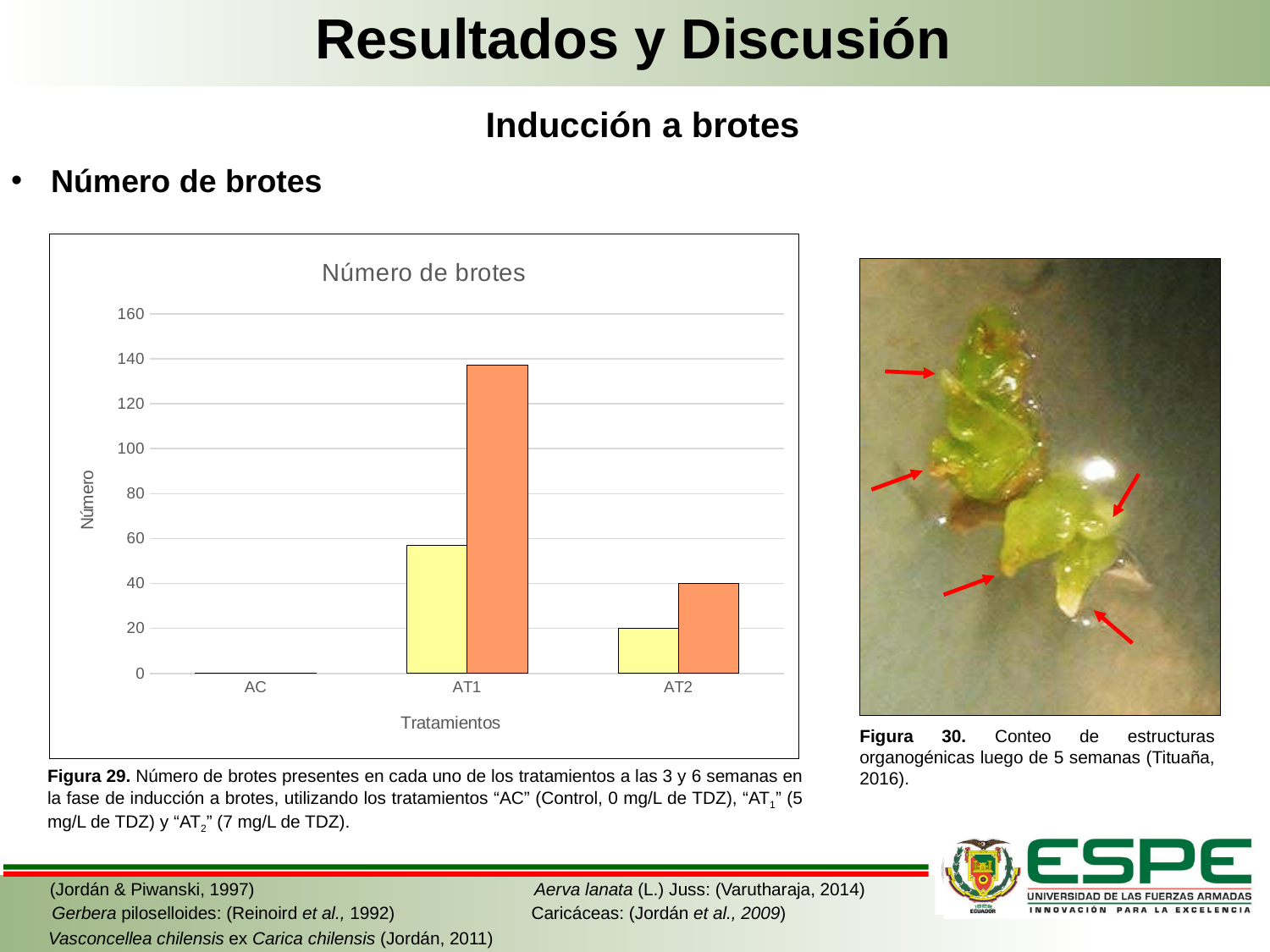
What is the label of the x axis of the chart? Tratamientos Is the value of the orange bar for AT1 greater or less than 120? greater What is the title of the chart? Número de brotes Which is larger, the orange bar for AT1 or the orange bar for AT2? AT1 Which treatment has the tallest bar in the chart? AT1 Is the value of the yellow bar for AT2 greater or less than 40? less Is the value of the yellow bar for AT1 greater or less than 40? greater How many treatment categories are shown on the x axis of the chart? 3 Which treatment has the lowest values in the chart? AC Do the values rise or fall from AT1 to AT2 in the chart? fall What kind of chart is shown on the slide? bar chart